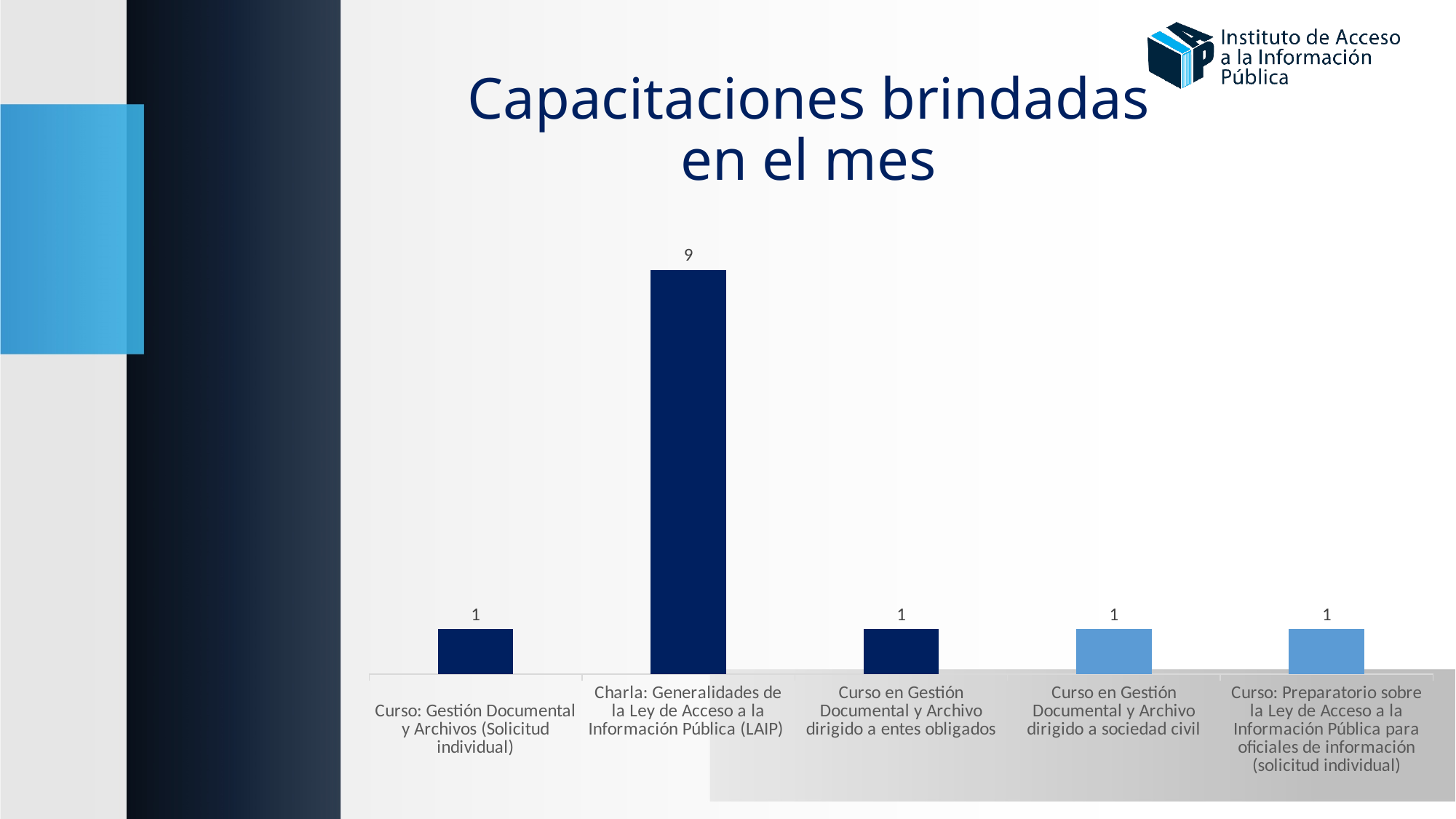
How many bars are drawn in a lighter blue colour? 2 What is the value for "Charla: Generalidades de la Ley de Acceso a la Información Pública (LAIP)"? 9 What is the title of the slide? Capacitaciones brindadas en el mes What is the value for "Curso en Gestión Documental y Archivo dirigido a sociedad civil"? 1 Which is larger: the value for "Charla: Generalidades de la Ley de Acceso a la Información Pública (LAIP)" or the value for "Curso: Preparatorio sobre la Ley de Acceso a la Información Pública para oficiales de información (solicitud individual)"? Charla: Generalidades de la Ley de Acceso a la Información Pública (LAIP) What is the difference between the value for "Charla: Generalidades de la Ley de Acceso a la Información Pública (LAIP)" and the value for "Curso en Gestión Documental y Archivo dirigido a entes obligados"? 8 What kind of chart is shown on the slide? Bar chart What is the value for "Curso: Gestión Documental y Archivos (Solicitud individual)"? 1 How many bars have a value of 1? 4 What is the total of all the values shown in the chart? 13 How many categories are shown in the chart? 5 Which category has the highest value? Charla: Generalidades de la Ley de Acceso a la Información Pública (LAIP)